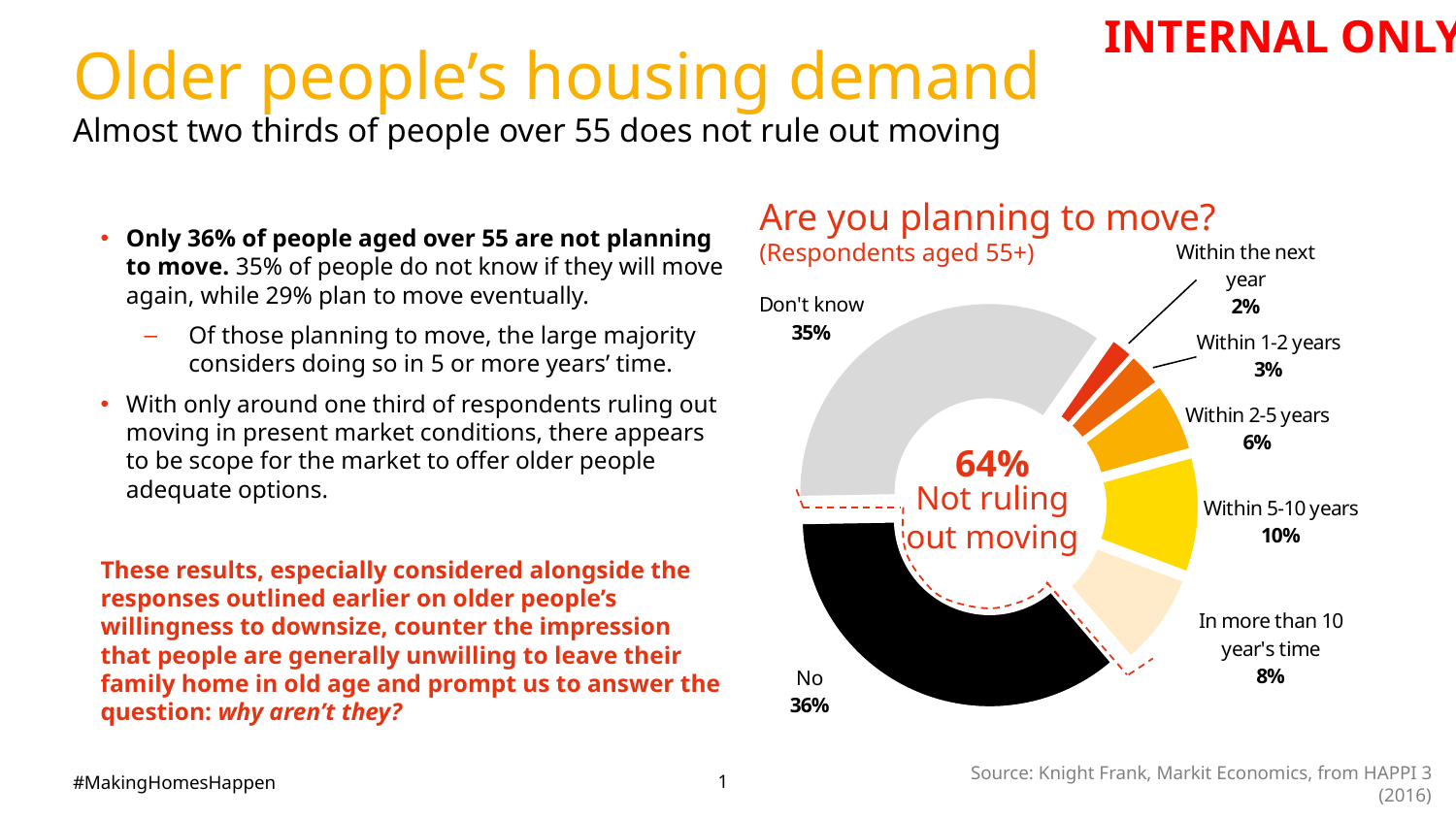
What is the title of the chart? Are you planning to move? Which is larger: the share for "Within 5-10 years" or the share for "In more than 10 year's time"? Within 5-10 years Which category has the smallest share of the chart? Within the next year What percentage of respondents plan to move within the next year? 2% What percentage of respondents plan to move within 5-10 years? 10% What percentage of respondents answered "No"? 36% What is the difference between the "Within 2-5 years" share and the "Within 1-2 years" share? 3% How many categories are shown in the chart? 7 What kind of chart is shown on the slide? Donut (pie) chart Which category has the largest share of the chart? No What percentage of respondents plan to move in more than 10 year's time? 8% What percentage of respondents answered "Don't know"? 35%